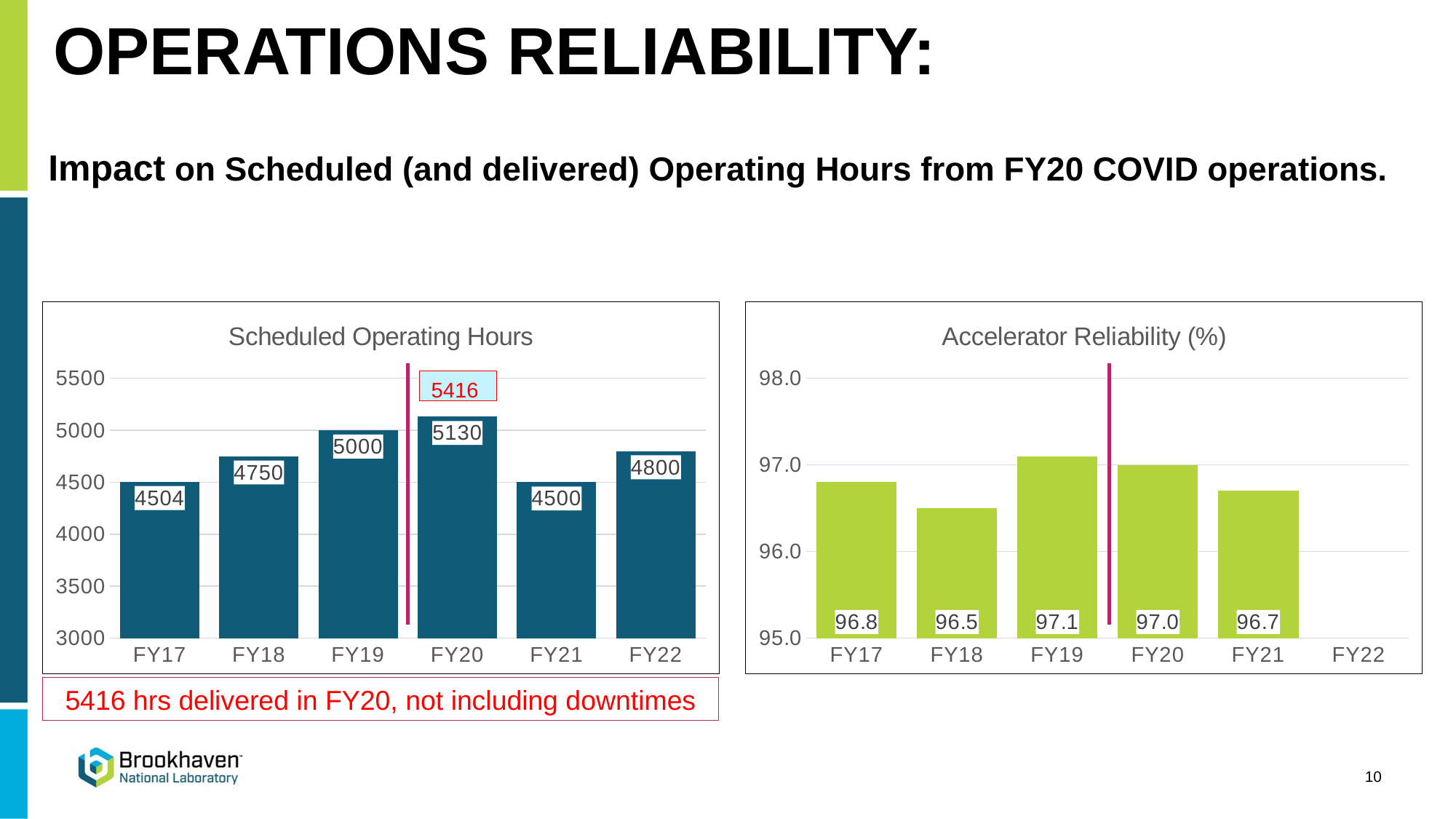
In the Scheduled Operating Hours chart, which is larger, the value for FY18 or the value for FY22? FY22 In the Scheduled Operating Hours chart, which fiscal year has the highest scheduled hours? FY20 In the Accelerator Reliability (%) chart, which fiscal year has the highest reliability? FY19 In the Scheduled Operating Hours chart, what is the value for FY17? 4504 In the Accelerator Reliability (%) chart, what is the value for FY18? 96.5 In the Scheduled Operating Hours chart, what is the value for FY19? 5000 In the Accelerator Reliability (%) chart, what is the difference between the FY19 and FY18 values? 0.6 In the Scheduled Operating Hours chart, which fiscal year has the lowest scheduled hours? FY21 In the Accelerator Reliability (%) chart, how many fiscal years have a bar plotted? 5 What type of chart is the Accelerator Reliability (%) chart? Bar chart In the Scheduled Operating Hours chart, what is the difference between the FY20 and FY21 values? 630 In the Scheduled Operating Hours chart, how many fiscal years are shown on the x axis? 6